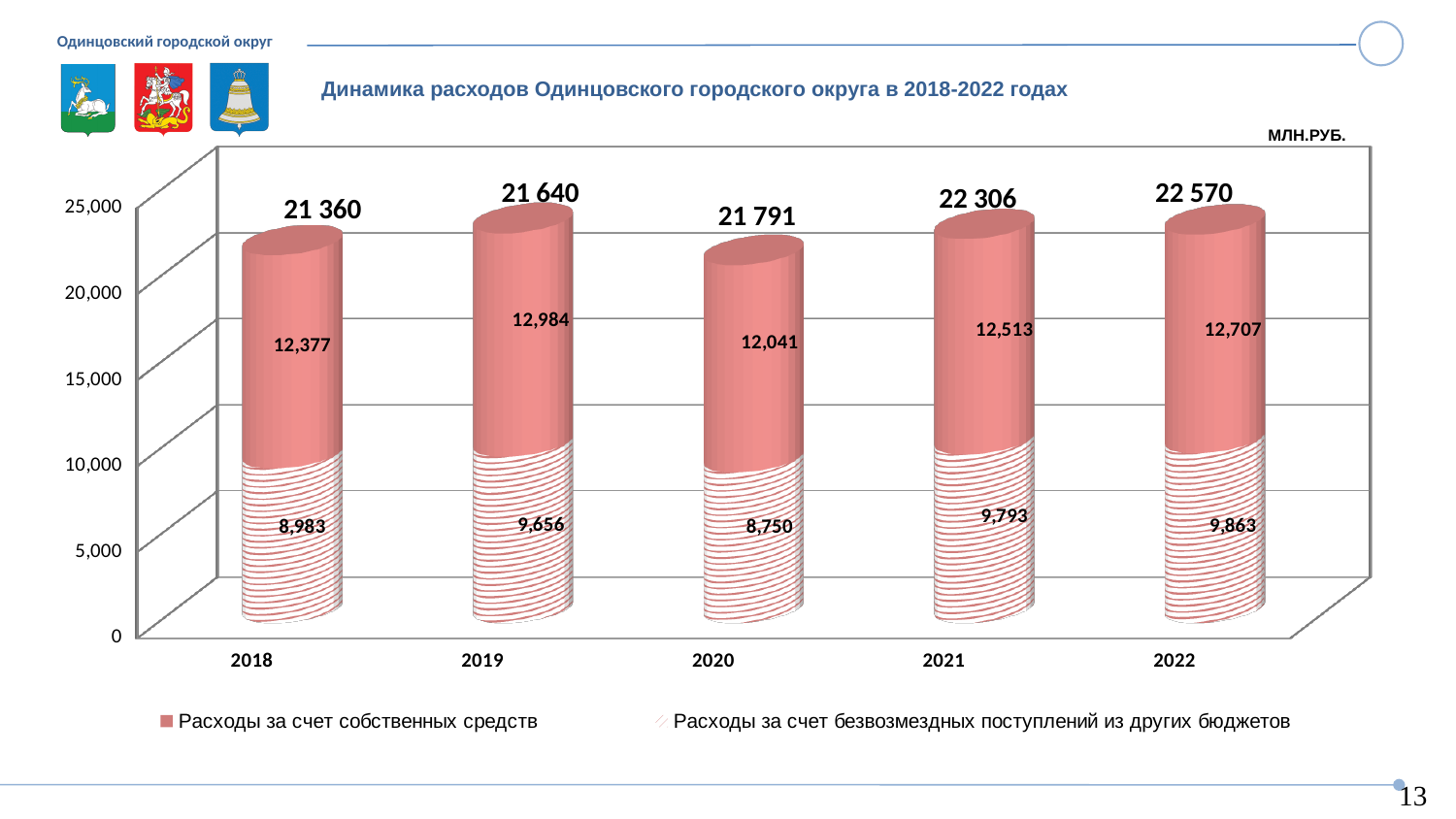
In which year is 'Расходы за счет безвозмездных поступлений из других бюджетов' the lowest? 2020 Do the total expenditures rise or fall from 2018 to 2022? Rise Is the total bar height for 2021 greater or less than 20,000? greater How many series does the legend list? 2 Which is larger: 'Расходы за счет безвозмездных поступлений из других бюджетов' in 2018 or in 2019? 2019 In which year is 'Расходы за счет собственных средств' the highest? 2019 What is the value of 'Расходы за счет безвозмездных поступлений из других бюджетов' for 2021? 9,793 What kind of chart is shown on the slide? Stacked bar chart What is the value of 'Расходы за счет собственных средств' for 2020? 12,041 What is the difference between 'Расходы за счет собственных средств' and 'Расходы за счет безвозмездных поступлений из других бюджетов' in 2022? 2,844 How many years are shown on the x axis? 5 What is the total labelled above the stacked bar for 2019? 21 640